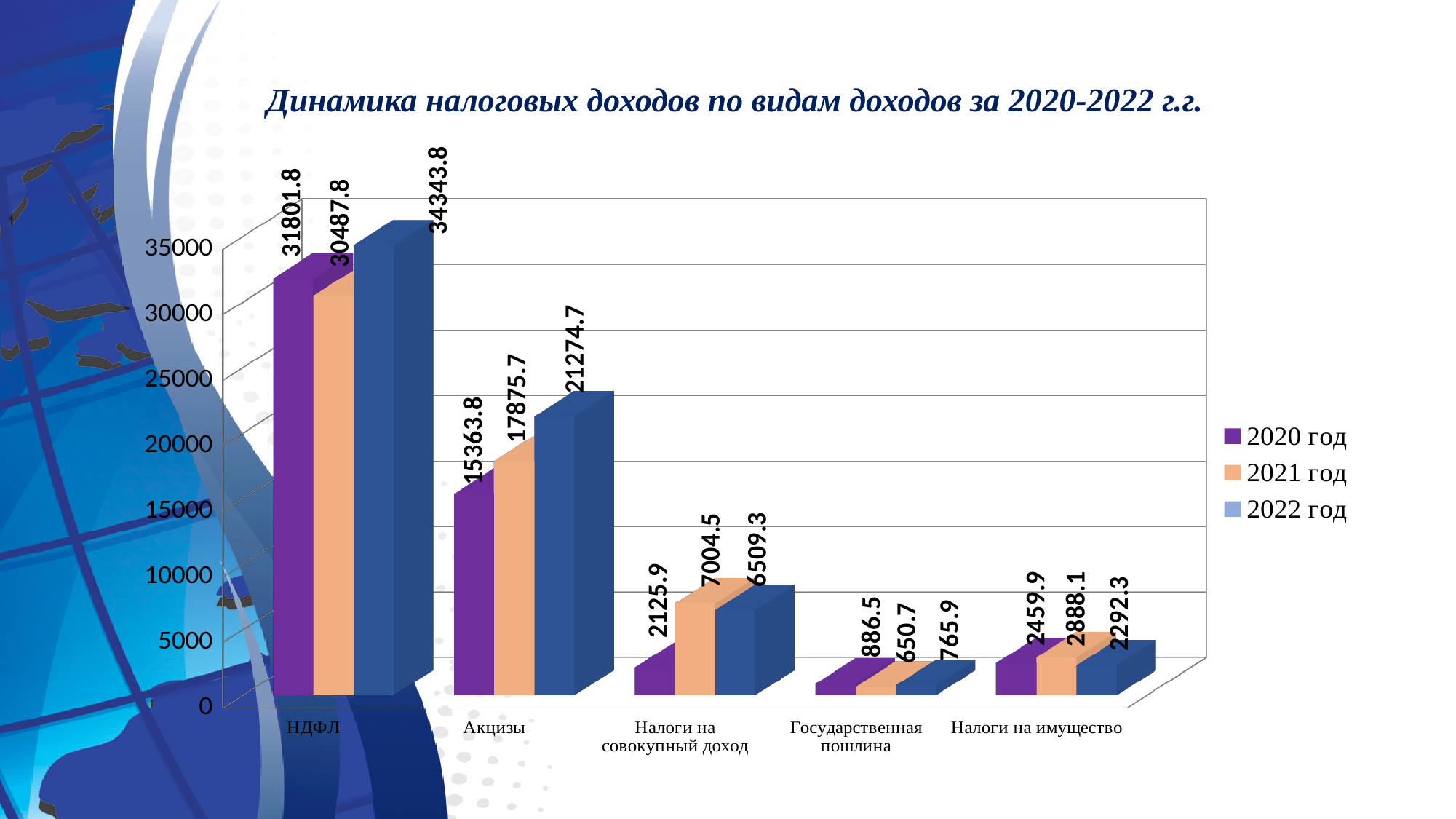
How many series does the legend list? 3 Which category has the lowest value in the 2020 год series? Государственная пошлина How many categories are shown on the x axis? 5 What is the value for Акцизы in the 2020 год series? 15363.8 Which is larger for Налоги на имущество: the 2021 год value or the 2022 год value? 2021 год What is the difference between the 2022 год and 2020 год values for Акцизы? 5910.9 What is the value for Налоги на совокупный доход in the 2021 год series? 7004.5 What is the value for НДФЛ in the 2022 год series? 34343.8 Which category has the highest value in the 2021 год series? НДФЛ Is the 2022 год value for Акцизы greater or less than 20000? greater What is the value for Государственная пошлина in the 2022 год series? 765.9 What kind of chart is shown on the slide? Bar chart